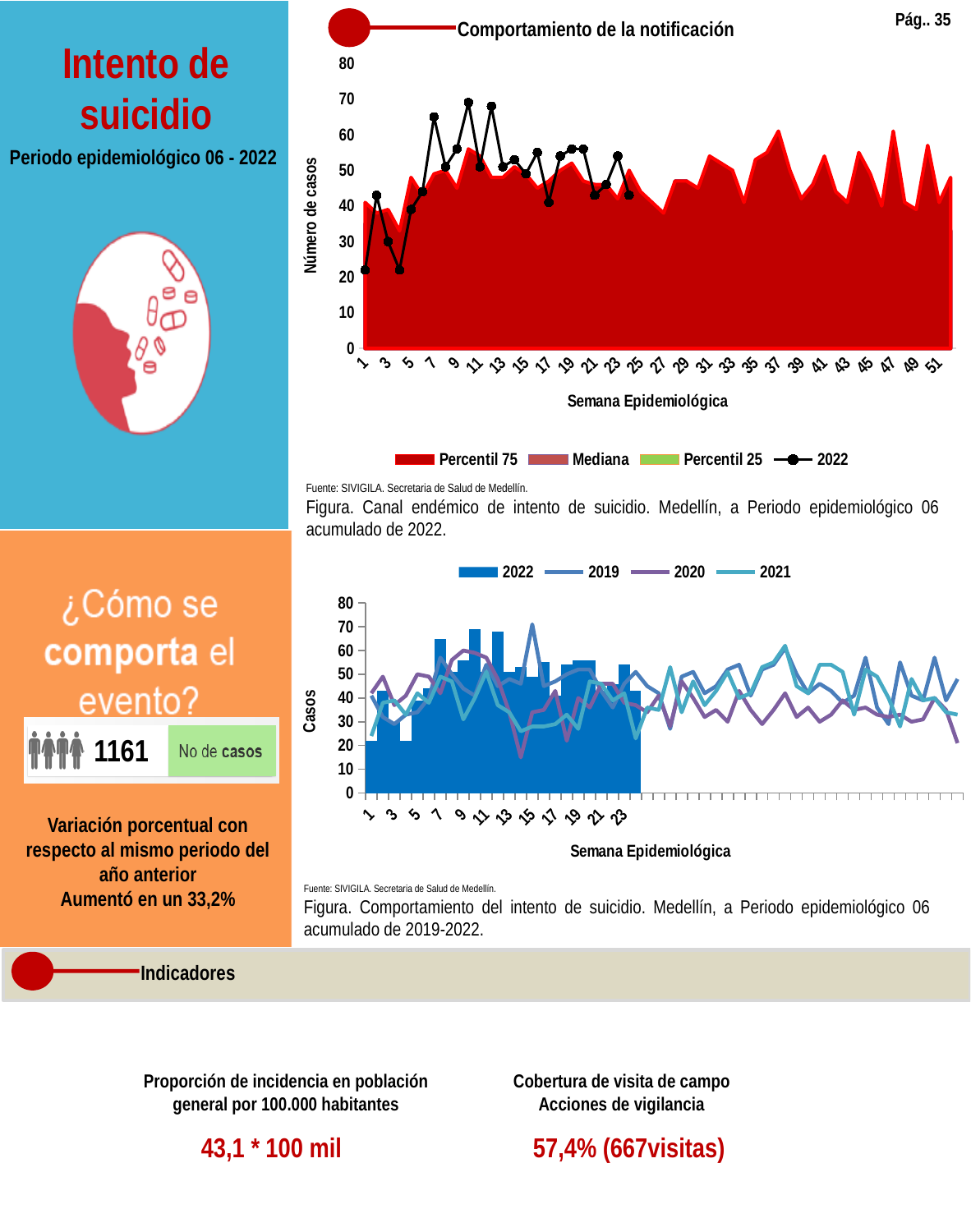
In the top chart 'Comportamiento de la notificación', which is larger for 2022: the value at week 10 or the value at week 1? week 10 In the top chart 'Comportamiento de la notificación', how many series does the legend list? 4 In the bottom chart (Comportamiento del intento de suicidio 2019-2022), is the 2022 bar at week 1 greater or less than 30? less In the bottom chart (Comportamiento del intento de suicidio 2019-2022), do the 2022 bars generally rise or fall from week 1 to week 10? rise In the bottom chart (Comportamiento del intento de suicidio 2019-2022), which series is drawn as bars rather than lines? 2022 In the top chart 'Comportamiento de la notificación', is the 2022 value at week 1 greater or less than 30? less In the top chart 'Comportamiento de la notificación', is the 2022 value at week 4 greater or less than 30? less What kind of chart is the bottom chart (Comportamiento del intento de suicidio 2019-2022)? bar chart combined with line series What is the y-axis title of the top chart 'Comportamiento de la notificación'? Número de casos In the bottom chart (Comportamiento del intento de suicidio 2019-2022), how many series does the legend list? 4